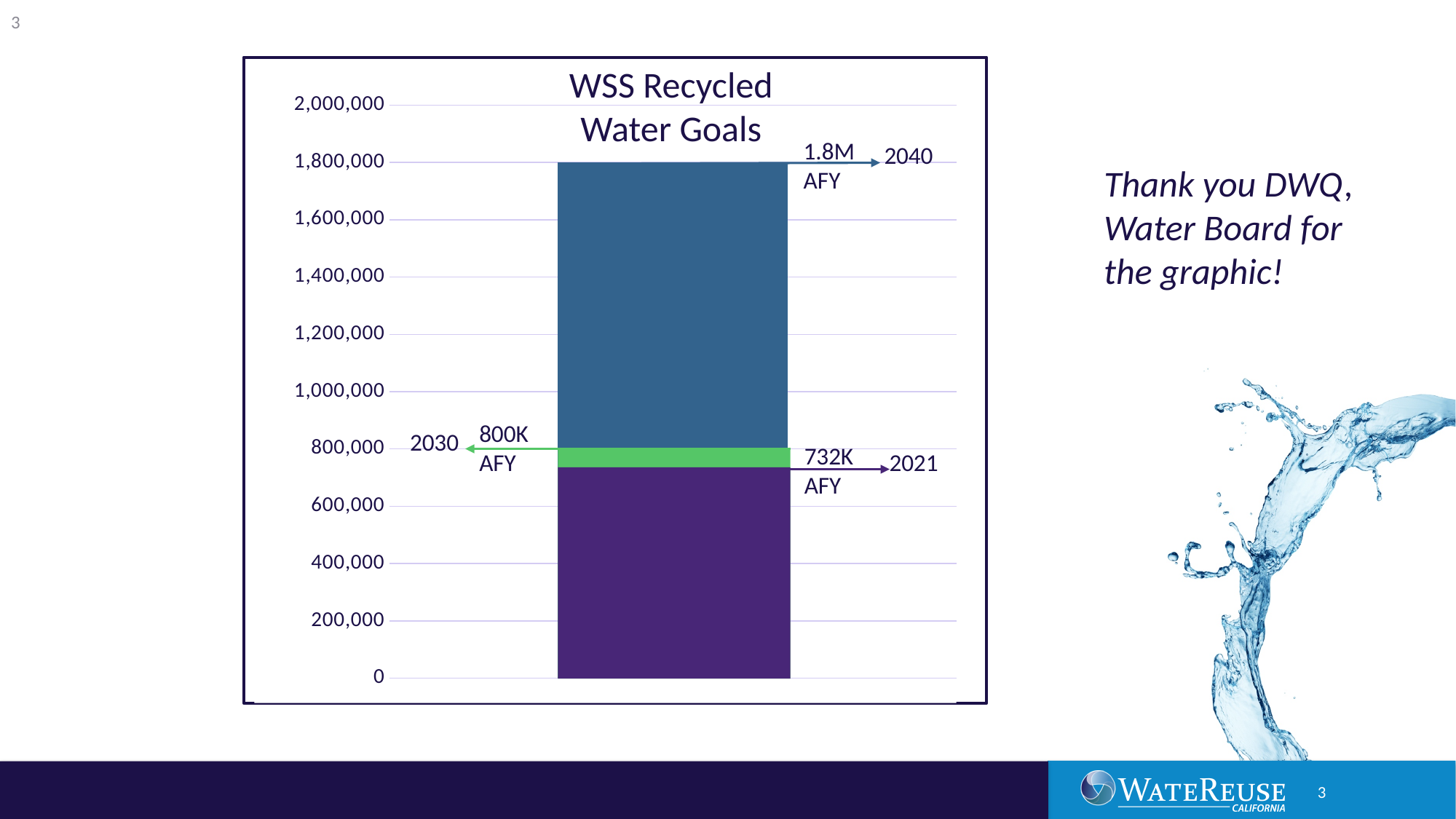
How much higher is the 2030 goal than the 2021 goal? 68K AFY What is the highest value shown on the vertical axis? 2,000,000 How many coloured segments make up the stacked bar? 3 Which is larger, the 2030 goal or the 2040 goal? 2040 goal What is the recycled water goal labelled for 2021? 732K AFY Which year has the lowest recycled water goal? 2021 What is the recycled water goal labelled for 2030? 800K AFY Is the 2040 goal greater or less than 1,600,000? greater Which year has the highest recycled water goal? 2040 What is the title of the chart? WSS Recycled Water Goals What is the recycled water goal labelled for 2040? 1.8M AFY What kind of chart is shown on the slide? stacked bar chart